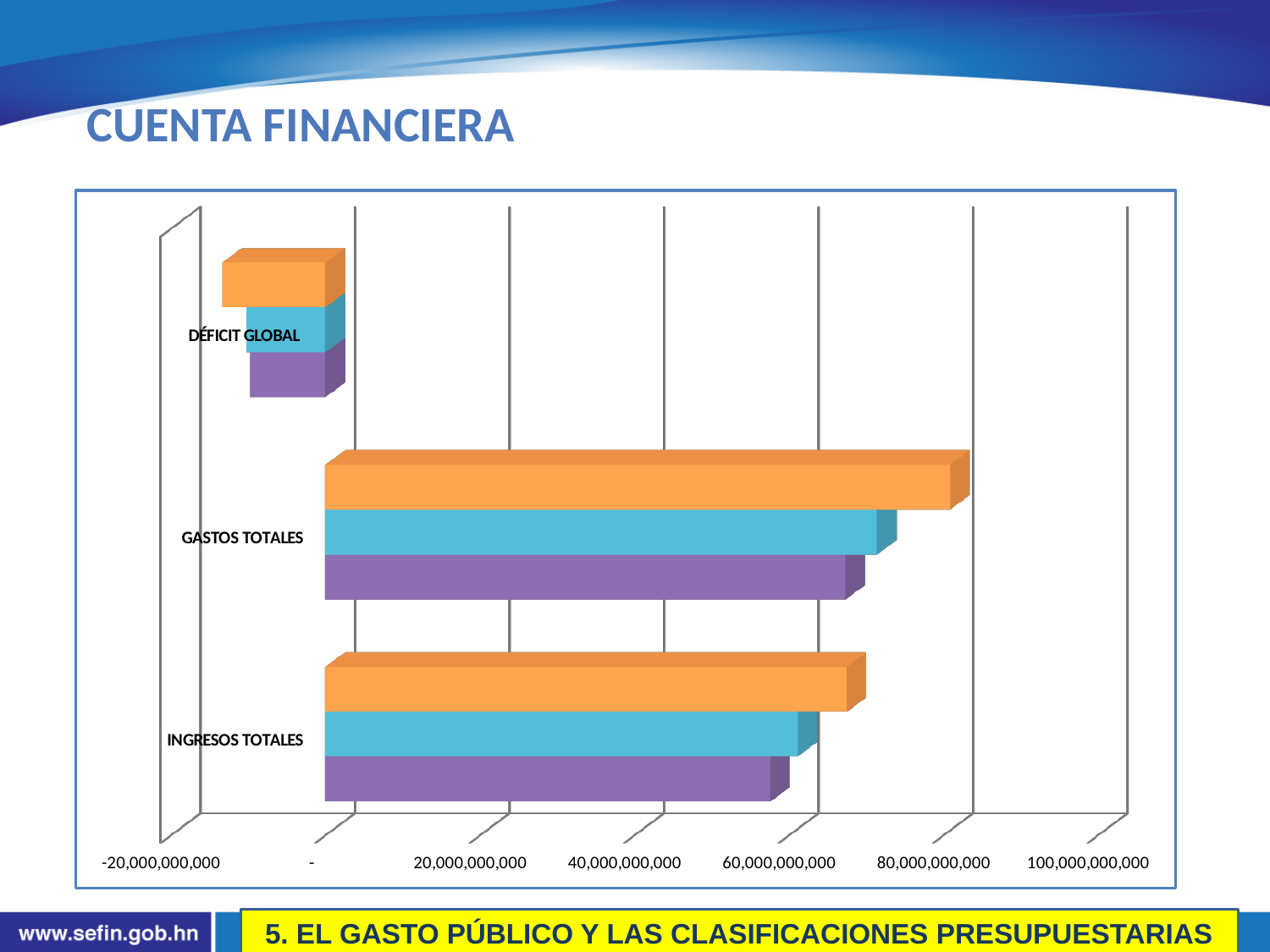
Which category has the longest bar in the chart? GASTOS TOTALES How many categories are shown on the vertical axis of the chart? 3 How many bars are plotted for each category in the chart? 3 Is the orange bar for DÉFICIT GLOBAL greater or less than 0? less Is the orange bar for DÉFICIT GLOBAL greater or less than -20,000,000,000? greater Which is larger, the orange bar for GASTOS TOTALES or the orange bar for INGRESOS TOTALES? GASTOS TOTALES Is the orange bar for GASTOS TOTALES greater or less than 60,000,000,000? greater What kind of chart is shown on the slide? bar chart Which is larger, the purple bar for GASTOS TOTALES or the purple bar for INGRESOS TOTALES? GASTOS TOTALES Which category has the smallest values in the chart? DÉFICIT GLOBAL What is the title of the slide containing the chart? CUENTA FINANCIERA